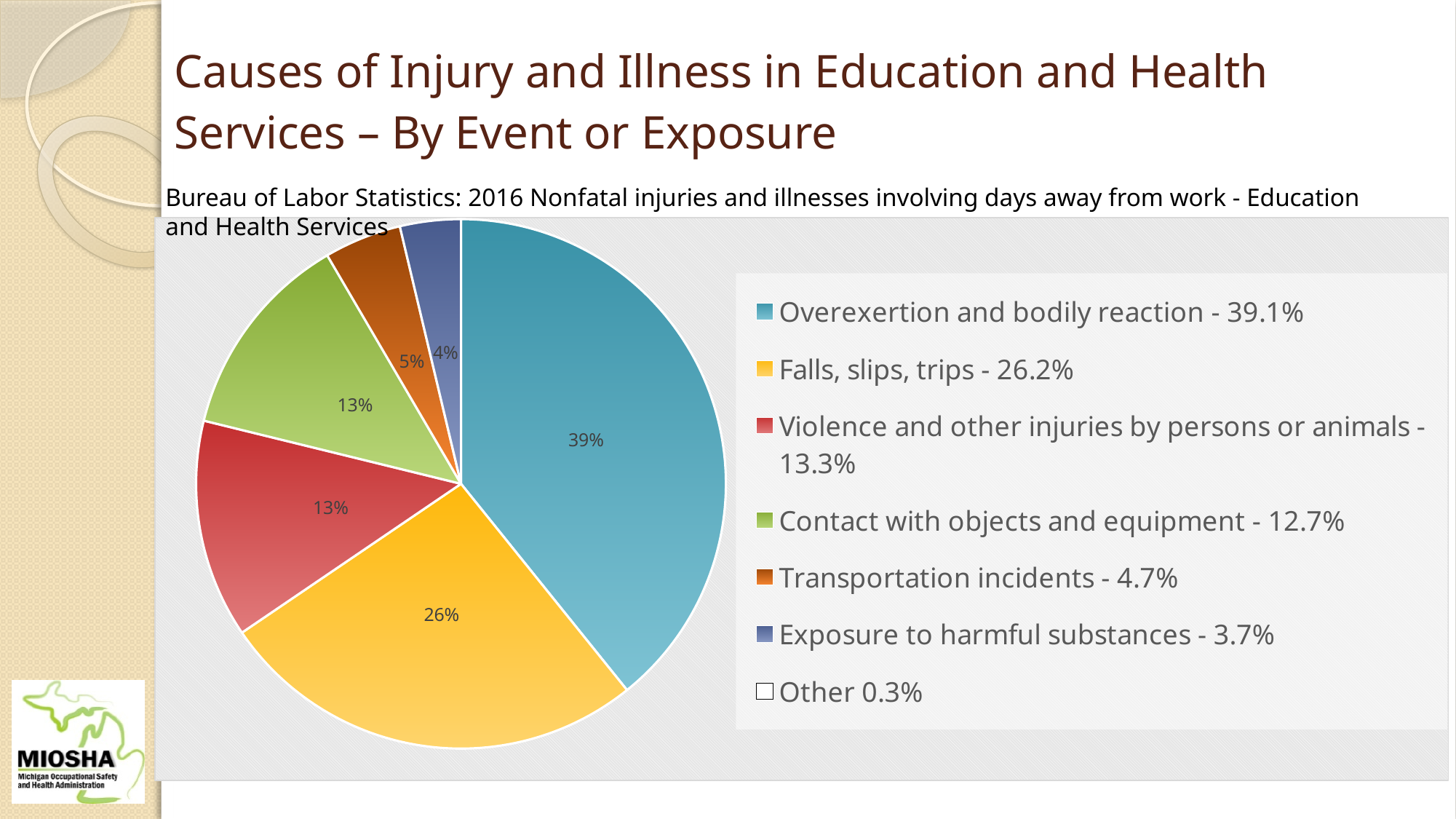
How many categories does the legend of the pie chart list? 7 Which category has the smallest share of the pie? Other Which category has the largest share of the pie? Overexertion and bodily reaction Which is larger according to the legend: Violence and other injuries by persons or animals, or Contact with objects and equipment? Violence and other injuries by persons or animals What kind of chart is shown on the slide? Pie chart According to the legend, what percentage is attributed to Contact with objects and equipment? 12.7% According to the legend, what percentage is attributed to Exposure to harmful substances? 3.7% What data label is printed on the Overexertion and bodily reaction slice of the pie? 39% According to the legend, what percentage is attributed to Falls, slips, trips? 26.2% Using the legend values, how many percentage points larger is Overexertion and bodily reaction than Falls, slips, trips? 12.9 According to the legend, what percentage is attributed to Transportation incidents? 4.7% What colour is the slice for Falls, slips, trips? Yellow